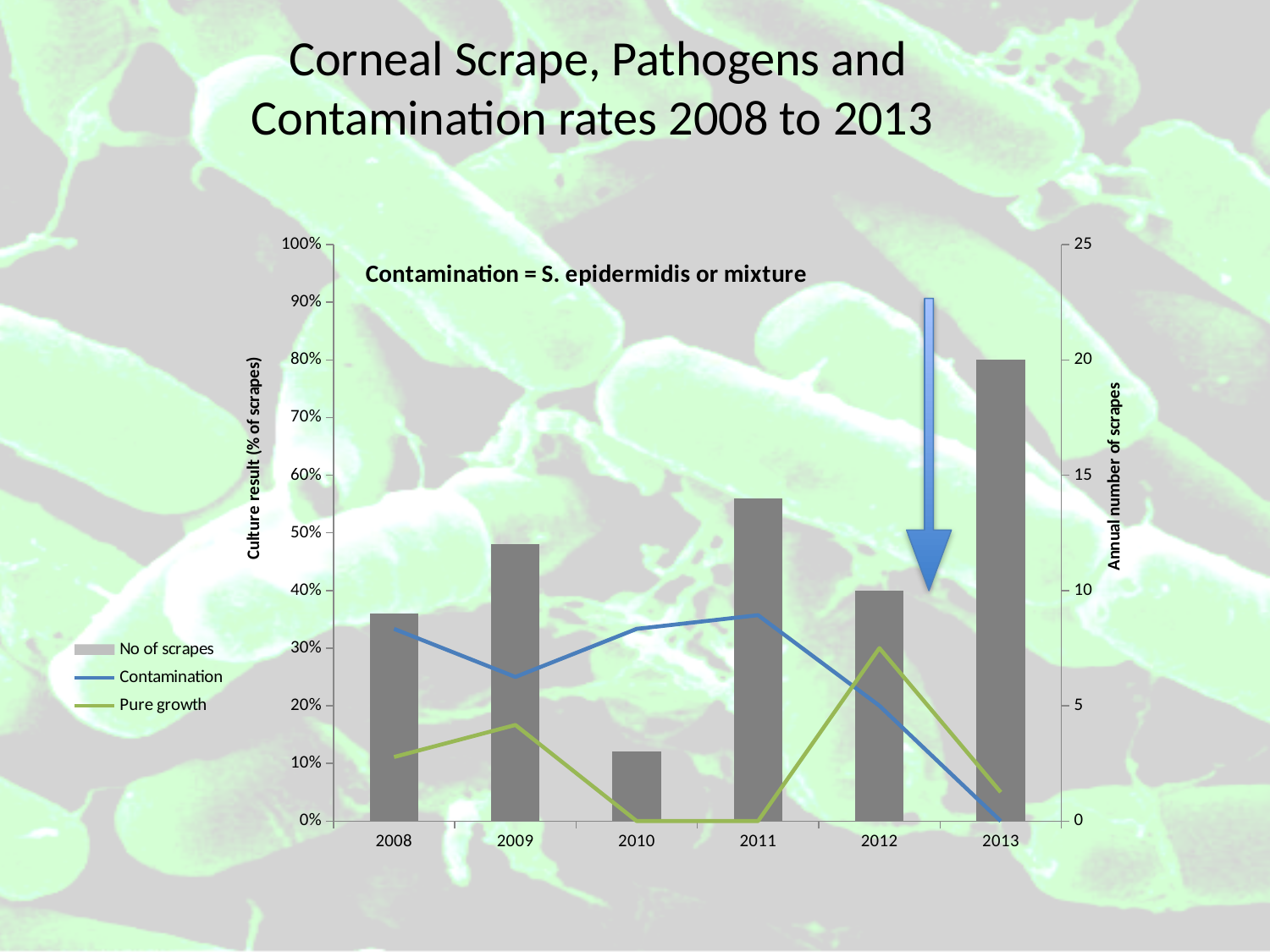
Which year has more scrapes, 2011 or 2012? 2011 Does the Contamination line rise or fall from 2011 to 2013? Falls Which year has the lowest number of scrapes? 2010 What is the annual number of scrapes in 2012? 10 What is the annual number of scrapes in 2013? 20 Which year has the highest number of scrapes? 2013 What is the Contamination rate in 2013? 0% How many years are shown on the x axis of the chart? 6 According to the annotation on the chart, what does Contamination equal? S. epidermidis or mixture What kind of chart is shown on the slide? A combined bar and line chart Is the number of scrapes in 2011 greater or less than 10? greater How many series does the legend list? 3